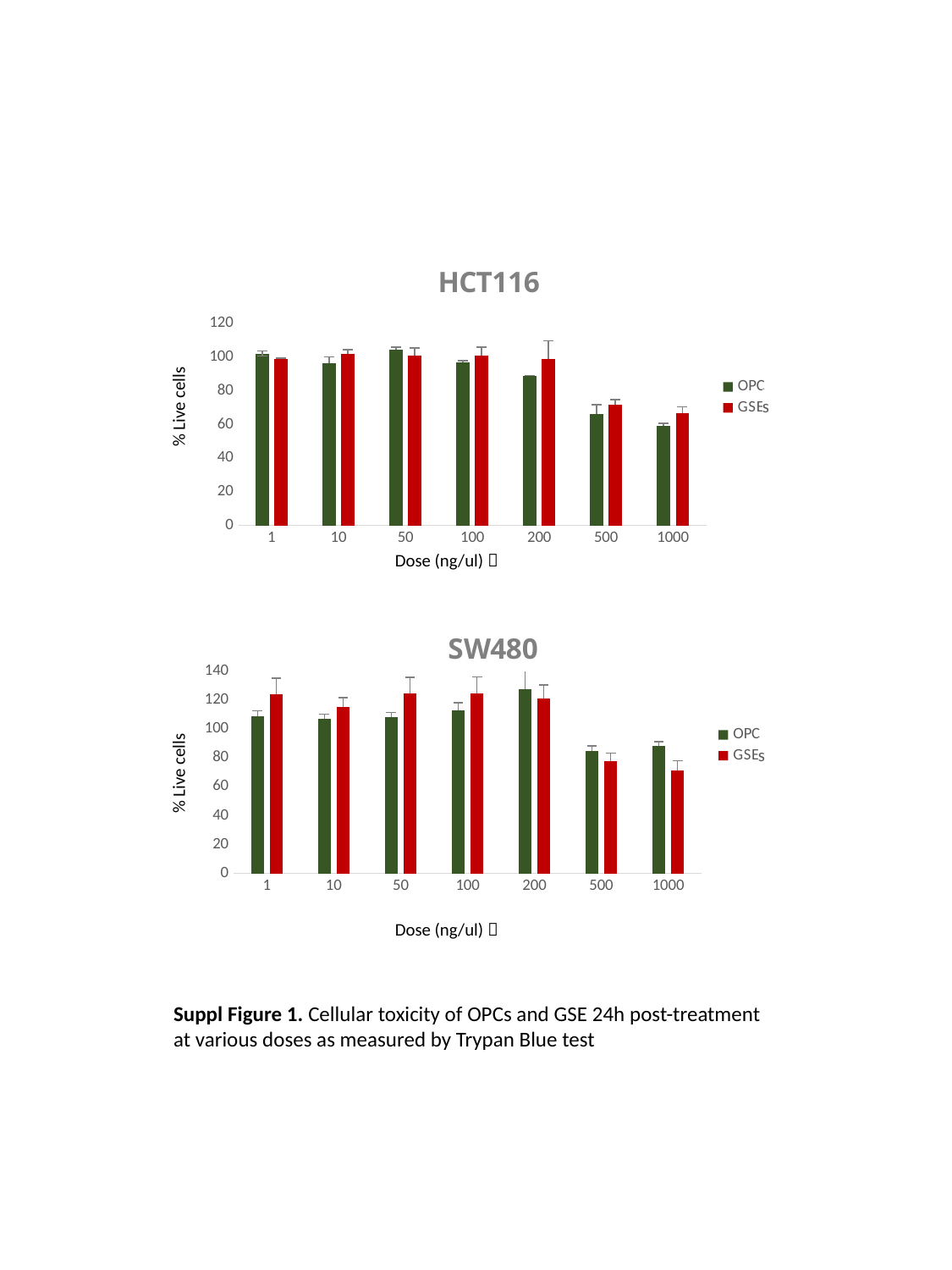
In the SW480 chart, how many series does the legend list? 2 What kind of chart is the HCT116 chart? bar chart In the HCT116 chart, is the OPC value at dose 1000 greater or less than 80? less In the HCT116 chart, how many dose categories are shown on the x axis? 7 In the HCT116 chart, do the OPC values rise or fall from dose 200 to dose 1000? fall In the SW480 chart, is the GSEs value at dose 1 greater or less than 100? greater In the HCT116 chart, at dose 200, which series has the larger value, OPC or GSEs? GSEs In the SW480 chart, at which dose is the GSEs value lowest? 1000 In the SW480 chart, at which dose is the OPC value highest? 200 What is the y-axis label of the SW480 chart? % Live cells In the SW480 chart, is the OPC value at dose 500 greater or less than 100? less In the HCT116 chart, at which dose is the OPC value lowest? 1000